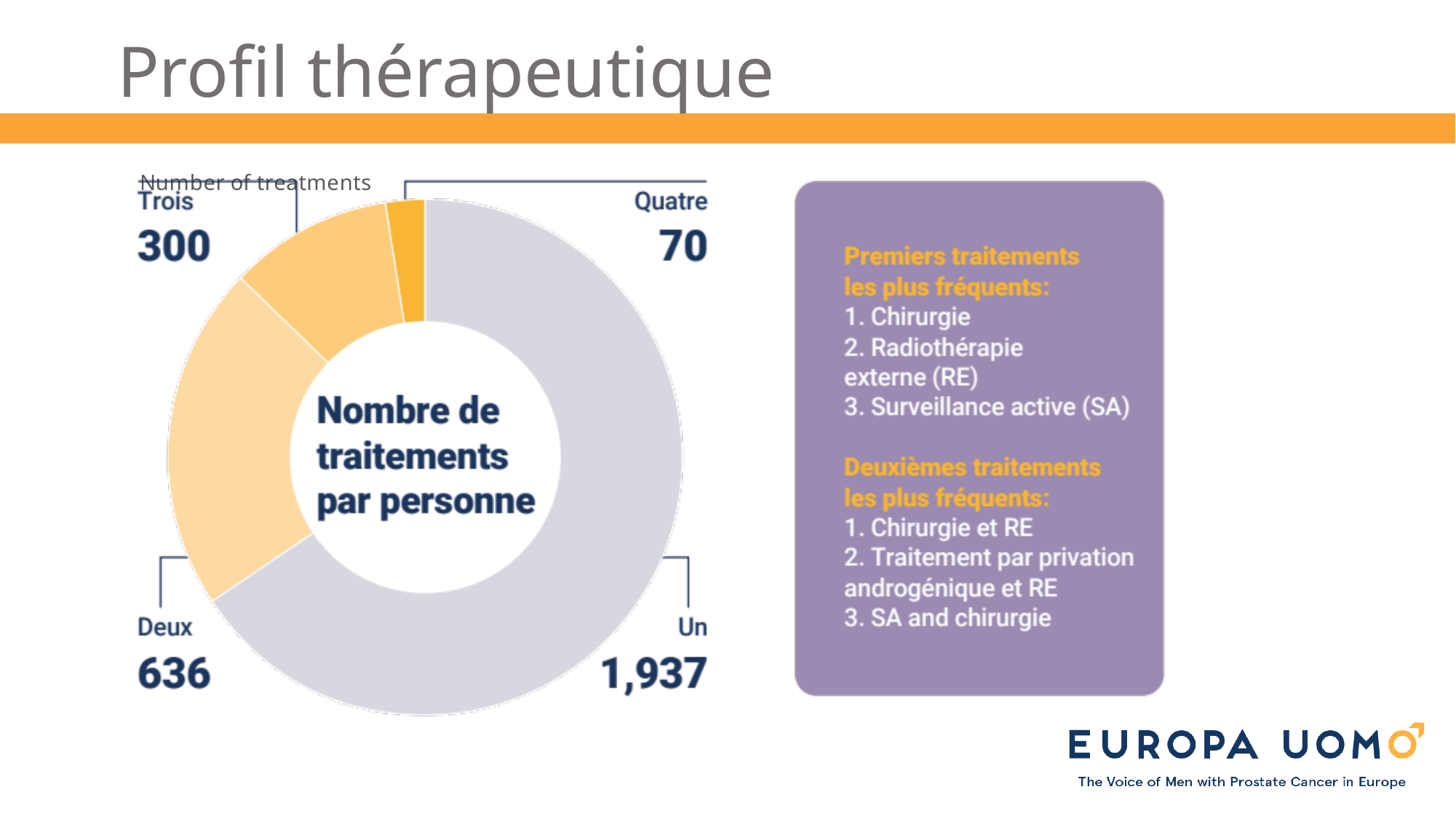
What is the difference between the values for "Un" and "Deux"? 1,301 What is the value for "Quatre" in the chart? 70 Which category has the highest value in the chart? Un Which category has the lowest value in the chart? Quatre What is the difference between the values for "Trois" and "Quatre"? 230 What is the value for "Un" in the chart? 1,937 What is the value for "Deux" in the chart? 636 How many categories does the chart show? 4 What kind of chart is shown on the slide? Donut (pie) chart Which is larger, the value for "Deux" or the value for "Trois"? Deux What is the value for "Trois" in the chart? 300 What is the title written in the centre of the chart? Nombre de traitements par personne